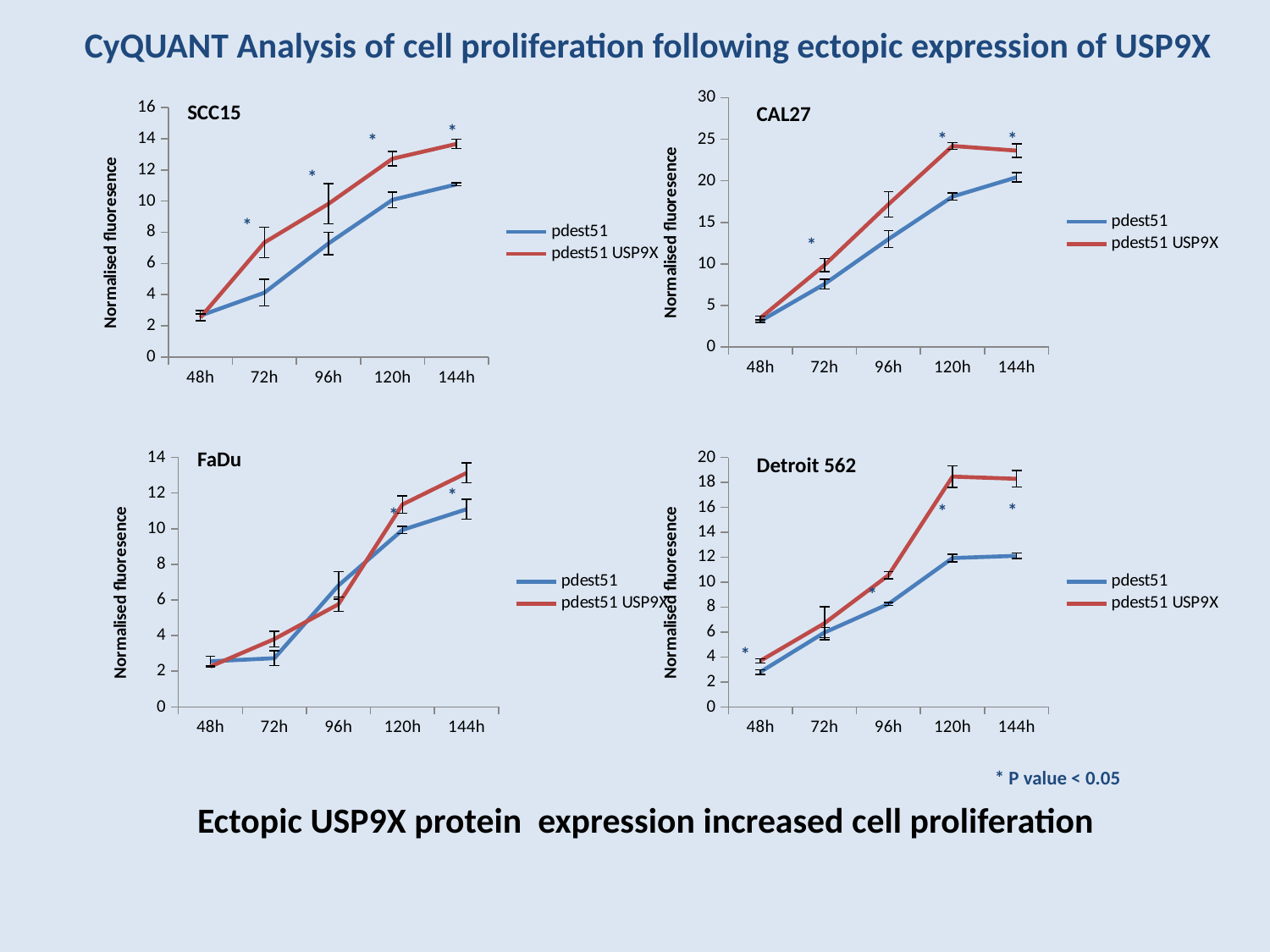
How many series does the legend of the FaDu chart list? 2 In the CAL27 chart, does the pdest51 series generally rise or fall from 48h to 144h? rise In the FaDu chart, which series has the larger value at 144h, pdest51 or pdest51 USP9X? pdest51 USP9X In the SCC15 chart, is the value for pdest51 at 48h greater or less than 4? less In the Detroit 562 chart, which series has the larger value at 144h, pdest51 or pdest51 USP9X? pdest51 USP9X In the SCC15 chart, is the value for pdest51 USP9X at 144h greater or less than 12? greater How many time points are plotted on the x axis of the CAL27 chart? 5 In the Detroit 562 chart, is the value for pdest51 USP9X at 120h greater or less than 16? greater What kind of chart is the SCC15 chart? line chart What is the y-axis label on the Detroit 562 chart? Normalised fluoresence